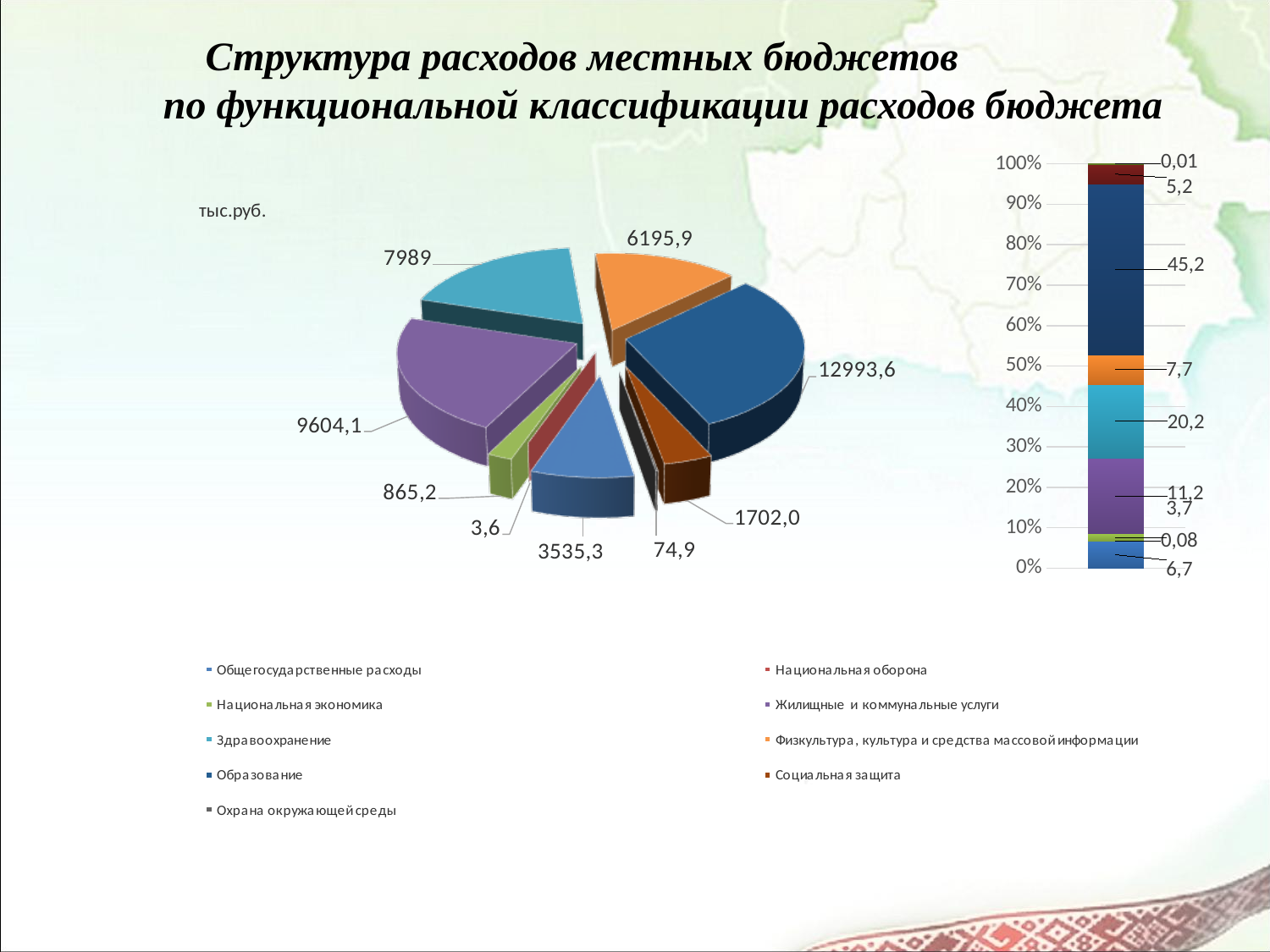
In the pie chart, which category has the largest value? Образование In the pie chart, what is the value for Здравоохранение? 7989 In the stacked bar chart, what is the percentage for Образование? 45,2 What kind of chart is the chart on the right of the slide? stacked bar chart In the pie chart, which is larger: Физкультура, культура и средства массовой информации or Общегосударственные расходы? Физкультура, культура и средства массовой информации What unit is shown for the pie chart values? тыс.руб. How many categories does the legend list? 9 What kind of chart is the chart on the left of the slide? pie chart In the pie chart, what is the value for Образование? 12993,6 In the pie chart, what is the value for Социальная защита? 1702,0 In the pie chart, which category has the smallest value? Национальная оборона In the pie chart, what is the difference between the values for Образование and Жилищные и коммунальные услуги? 3389,5